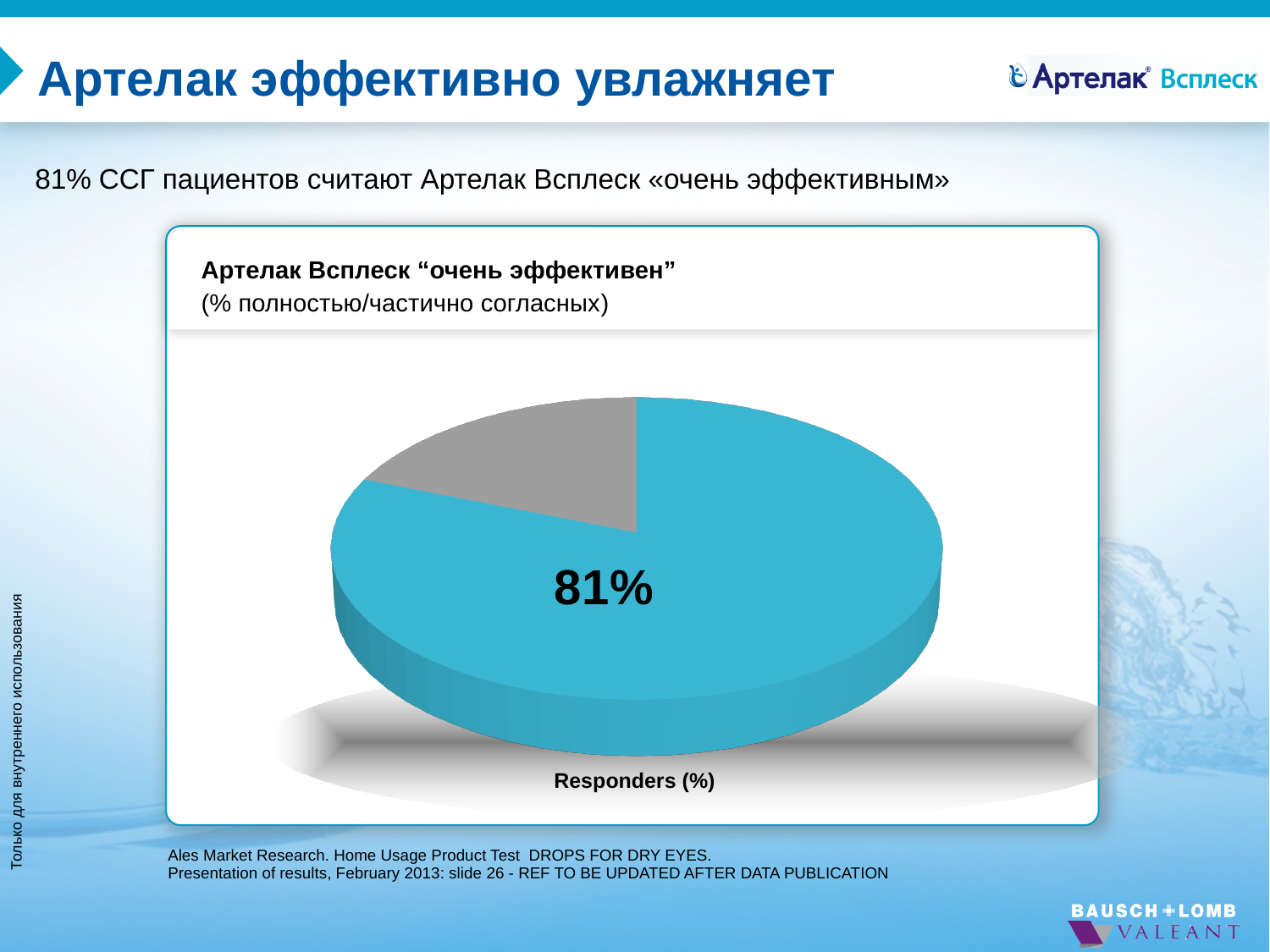
How many slices does the pie chart have? 2 Is the share of the grey slice greater or less than 50%? less What is the title of the chart? Артелак Всплеск “очень эффективен” (% полностью/частично согласных) Which slice of the pie chart is larger, the blue one or the grey one? the blue one What percentage is printed on the large blue slice of the pie chart? 81% Is the share of the blue slice greater or less than 50%? greater What kind of chart is shown on the slide? pie chart What is the label printed below the pie chart? Responders (%)